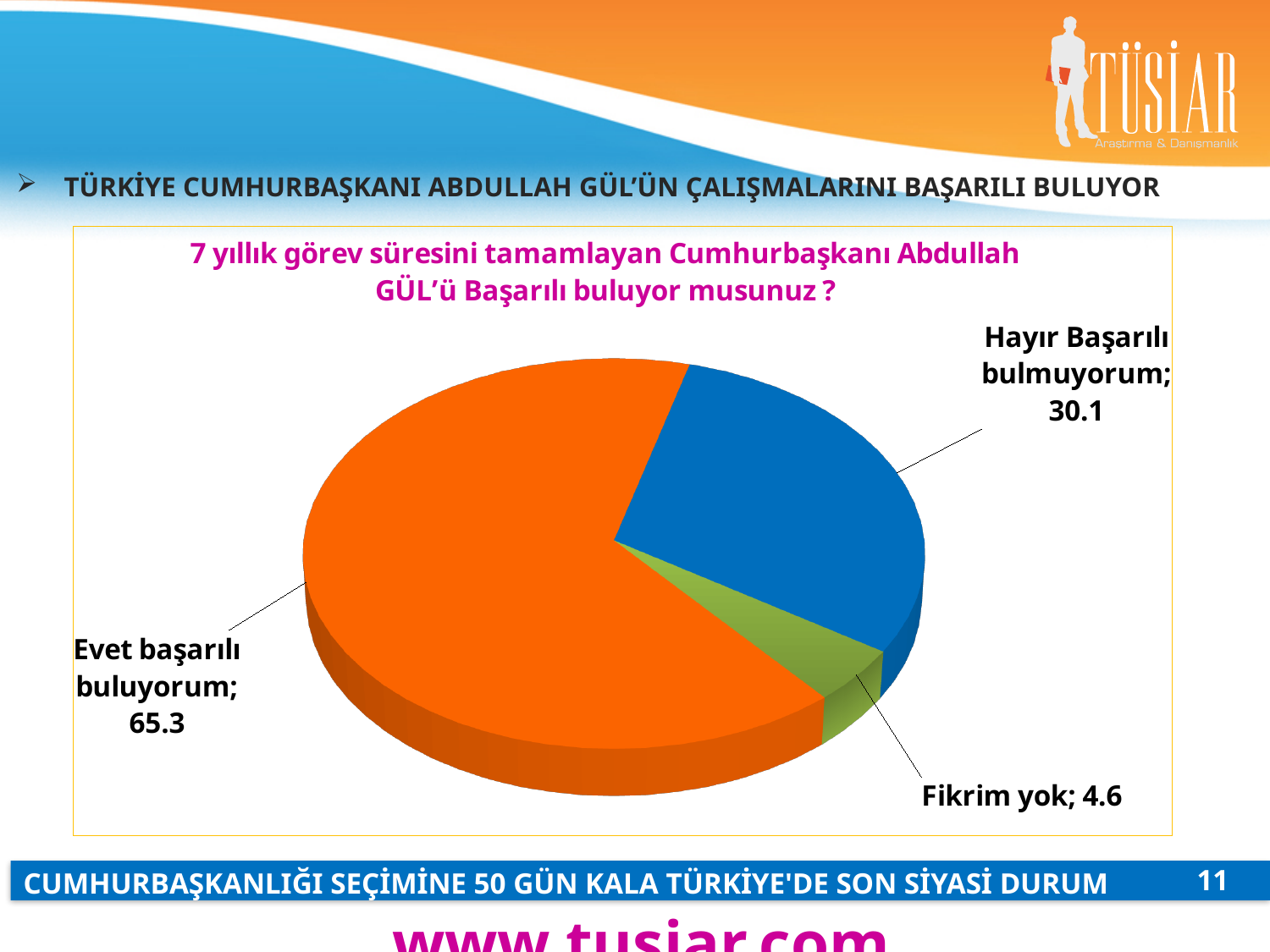
What is the title of the chart? 7 yıllık görev süresini tamamlayan Cumhurbaşkanı Abdullah GÜL'ü Başarılı buluyor musunuz ? How many categories are shown in the pie chart? 3 What is the value for "Hayır Başarılı bulmuyorum"? 30.1 Which category has the smallest slice of the pie? Fikrim yok What is the value for "Evet başarılı buluyorum"? 65.3 What is the difference between the values for "Hayır Başarılı bulmuyorum" and "Fikrim yok"? 25.5 What kind of chart is shown on the slide? Pie chart What is the difference between the values for "Evet başarılı buluyorum" and "Hayır Başarılı bulmuyorum"? 35.2 Which is larger, the value for "Hayır Başarılı bulmuyorum" or the value for "Fikrim yok"? Hayır Başarılı bulmuyorum Which category has the largest slice of the pie? Evet başarılı buluyorum What is the value for "Fikrim yok"? 4.6 What colour is the slice for "Fikrim yok"? Green